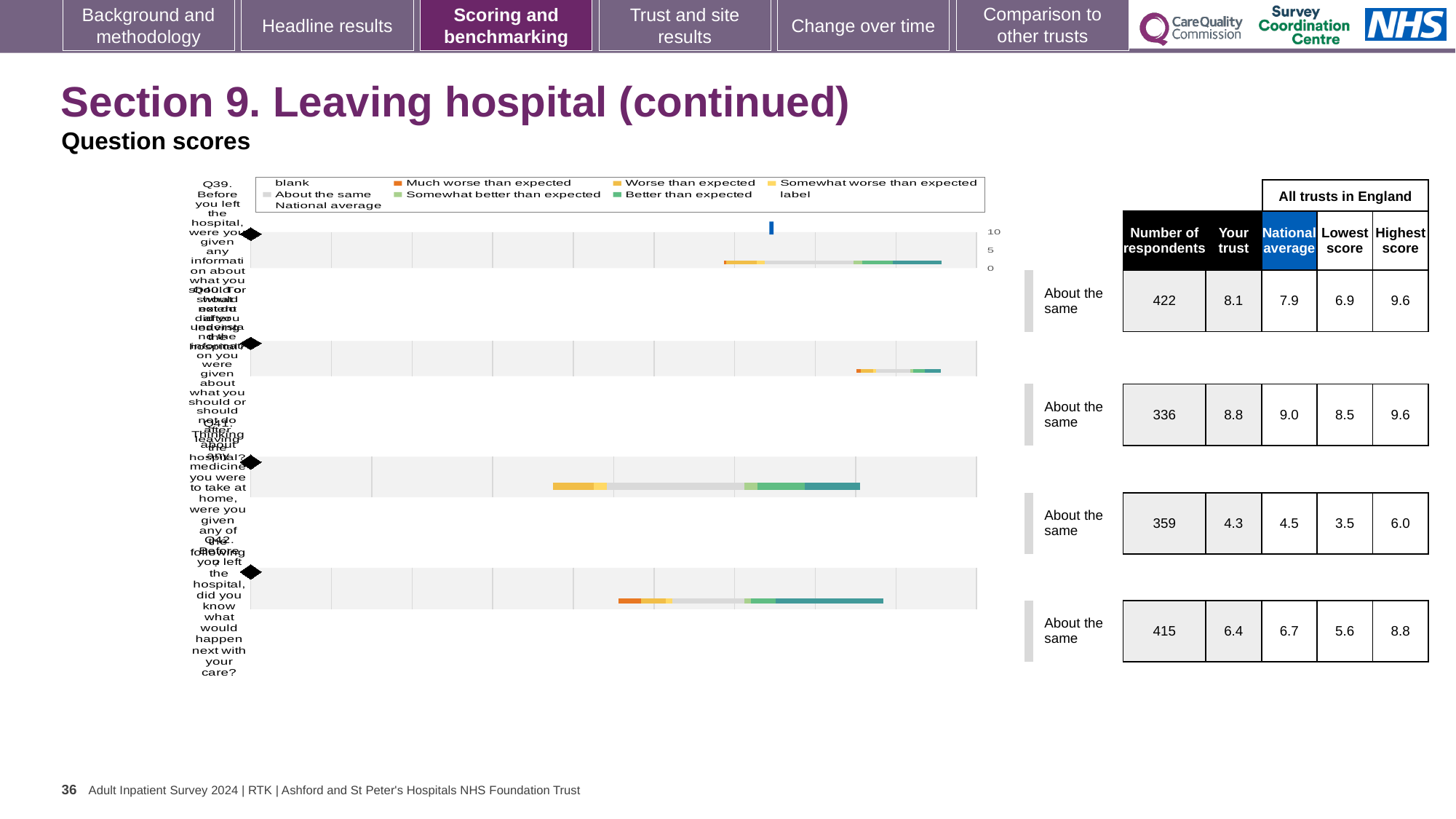
In the table, what is the 'Your trust' score in the first row (422 respondents)? 8.1 What kind of chart is shown on the slide? bar chart In the table, what is the lowest score across all trusts in England in the last row (415 respondents)? 5.6 What is the maximum value shown on the chart's score axis? 10 How many questions (bars) are plotted in the chart? 4 Which row of the table has the highest 'Your trust' score? the row with 336 respondents (8.8) What benchmark category is shown for every question on the slide? About the same In the first row of the table, what is the difference between the 'Your trust' score and the national average? 0.2 In the last row of the table (415 respondents), which is larger: the 'Your trust' score or the national average? National average In the table, what is the highest score across all trusts in England in the row with 359 respondents? 6.0 In the table, what is the national average in the row with 336 respondents? 9.0 Which row of the table has the lowest 'Your trust' score? the row with 359 respondents (4.3)